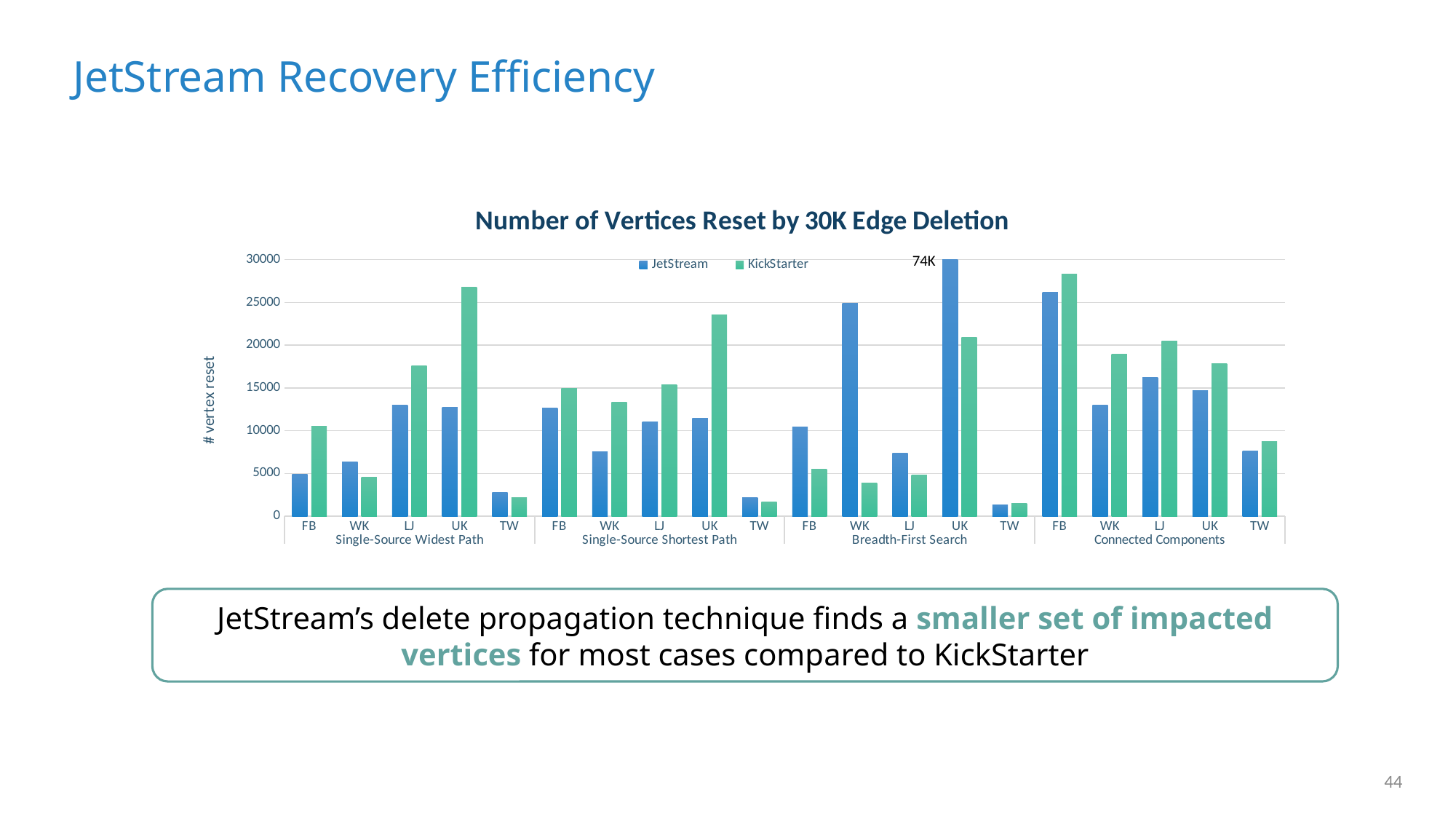
What kind of chart is shown on the slide? bar chart Which dataset and algorithm has the highest JetStream bar? UK under Breadth-First Search What is the title of the chart? Number of Vertices Reset by 30K Edge Deletion How many series does the chart legend list? 2 For LJ under Single-Source Widest Path, which series has the larger value, JetStream or KickStarter? KickStarter What is the JetStream value for UK under Breadth-First Search? 74K Is the KickStarter value for FB under Connected Components greater or less than 25000? greater What is the label of the y axis? # vertex reset For WK under Breadth-First Search, which series has the larger value, JetStream or KickStarter? JetStream How many algorithm groups are shown along the x axis? 4 Is the KickStarter value for UK under Single-Source Widest Path greater or less than 25000? greater Is the KickStarter value for UK under Single-Source Shortest Path greater or less than 20000? greater